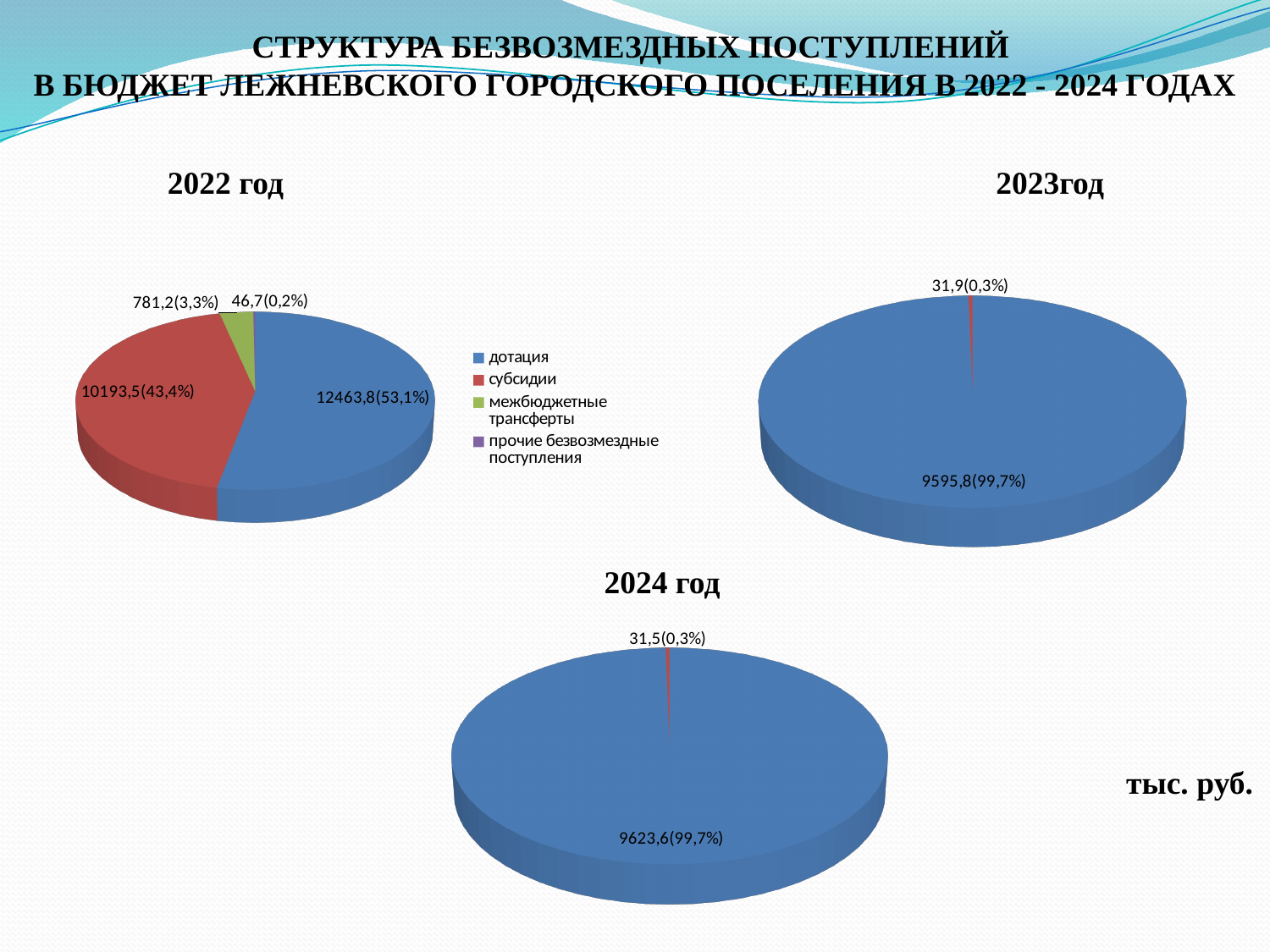
Which is larger: the blue slice value in the 2024 год chart or the blue slice value in the 2023год chart? 2024 год (9623,6) In the 2023год pie chart, what is the value of the small red slice? 31,9(0,3%) How many entries does the legend list? 4 In the 2022 год pie chart, what is the difference between the дотация value and the субсидии value? 2270,3 In the 2024 год pie chart, what share of the pie does the small red slice take? 0,3% In the 2022 год pie chart, what is the value shown for дотация? 12463,8(53,1%) In the 2022 год pie chart, which category has the largest slice? дотация What type of chart is used for each year on this slide? Pie chart In the 2022 год pie chart, which category has the smallest slice? прочие безвозмездные поступления In the 2023год pie chart, what is the value of the large blue slice? 9595,8(99,7%) In the 2022 год pie chart, what share of the pie does межбюджетные трансферты take? 3,3% In the 2022 год pie chart, what is the value shown for субсидии? 10193,5(43,4%)